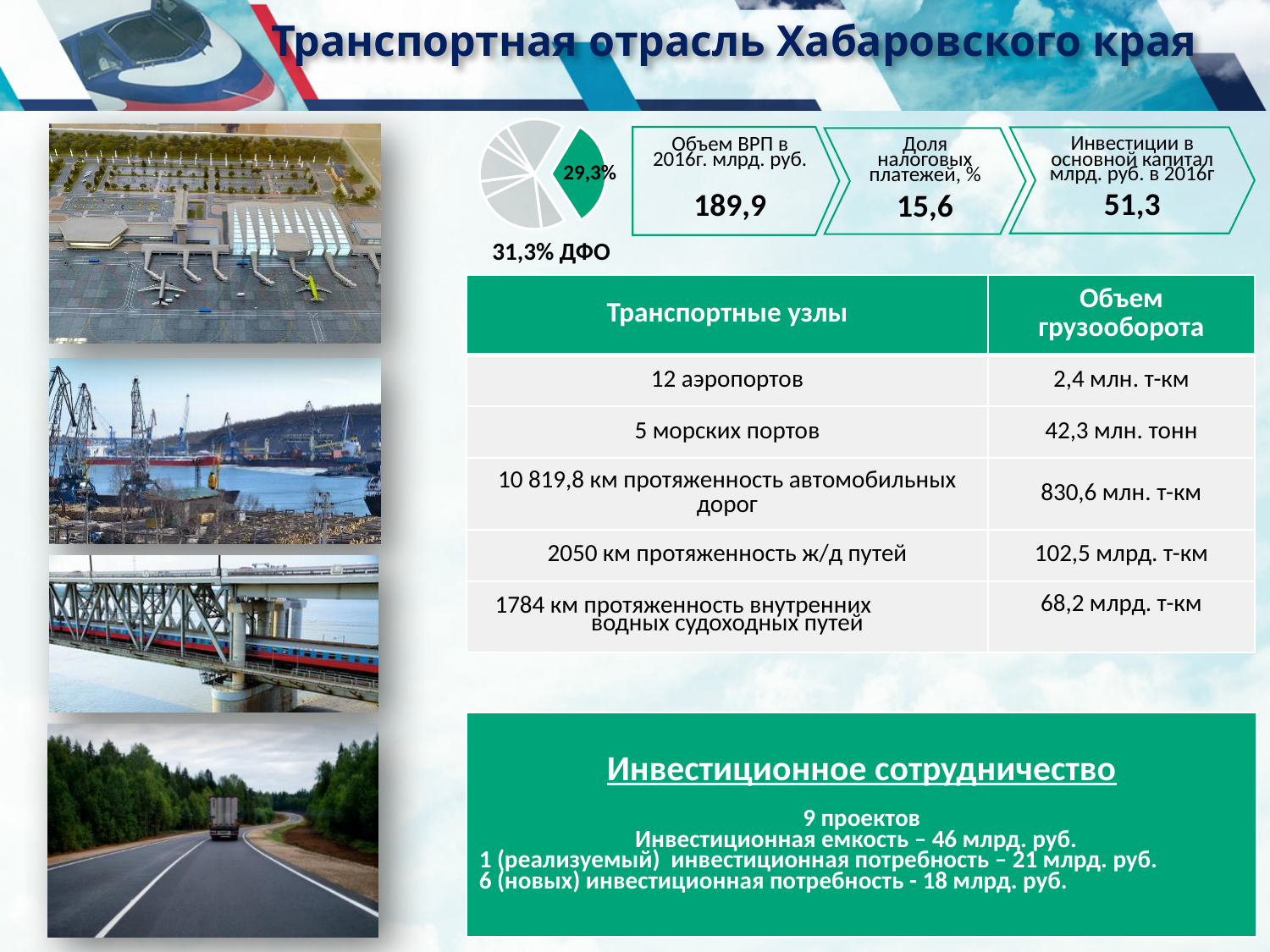
What colour is the slice of the pie chart that carries the data label? green What kind of chart is shown at the top of the slide next to the '29,3%' label? pie chart What percentage is printed on the highlighted (green) slice of the pie chart? 29,3% What share of the pie does the green, pulled-out slice represent? 29,3% How many slices of the pie chart have a printed data label? 1